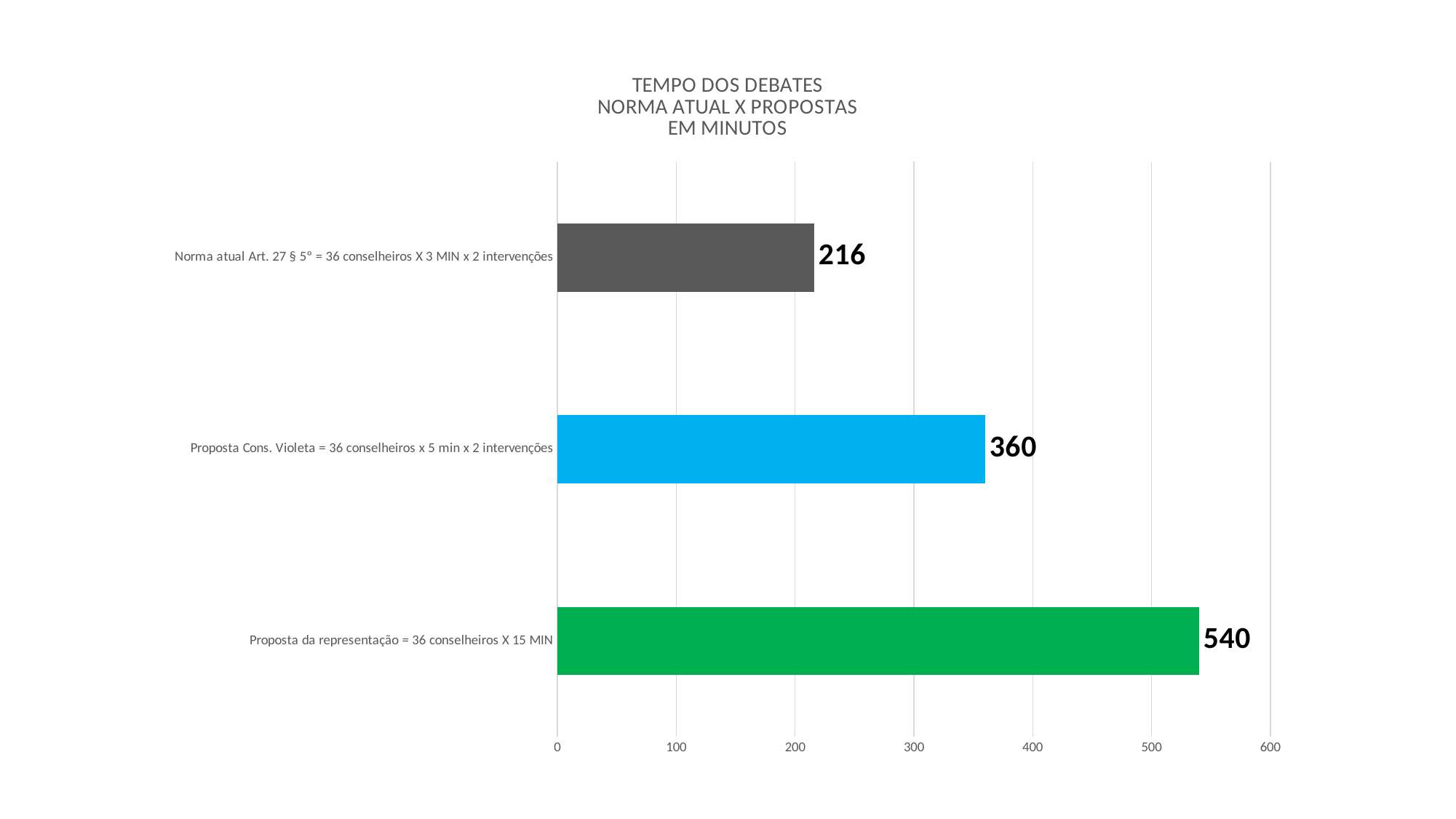
Which category has the highest value? Proposta da representação = 36 conselheiros X 15 MIN What kind of chart is shown on the slide? Bar chart Is the value for "Proposta Cons. Violeta" greater or less than 300? greater How many categories are shown in the chart? 3 What is the difference between the value for "Proposta da representação" and the value for "Norma atual Art. 27 § 5º"? 324 Which is larger: the value for "Proposta Cons. Violeta" or the value for "Norma atual Art. 27 § 5º"? Proposta Cons. Violeta What is the value for "Norma atual Art. 27 § 5º = 36 conselheiros X 3 MIN x 2 intervenções"? 216 What is the value for "Proposta da representação = 36 conselheiros X 15 MIN"? 540 What is the value for "Proposta Cons. Violeta = 36 conselheiros x 5 min x 2 intervenções"? 360 What is the difference between the value for "Proposta Cons. Violeta" and the value for "Norma atual Art. 27 § 5º"? 144 What is the title of the chart? TEMPO DOS DEBATES NORMA ATUAL X PROPOSTAS EM MINUTOS Which category has the lowest value? Norma atual Art. 27 § 5º = 36 conselheiros X 3 MIN x 2 intervenções